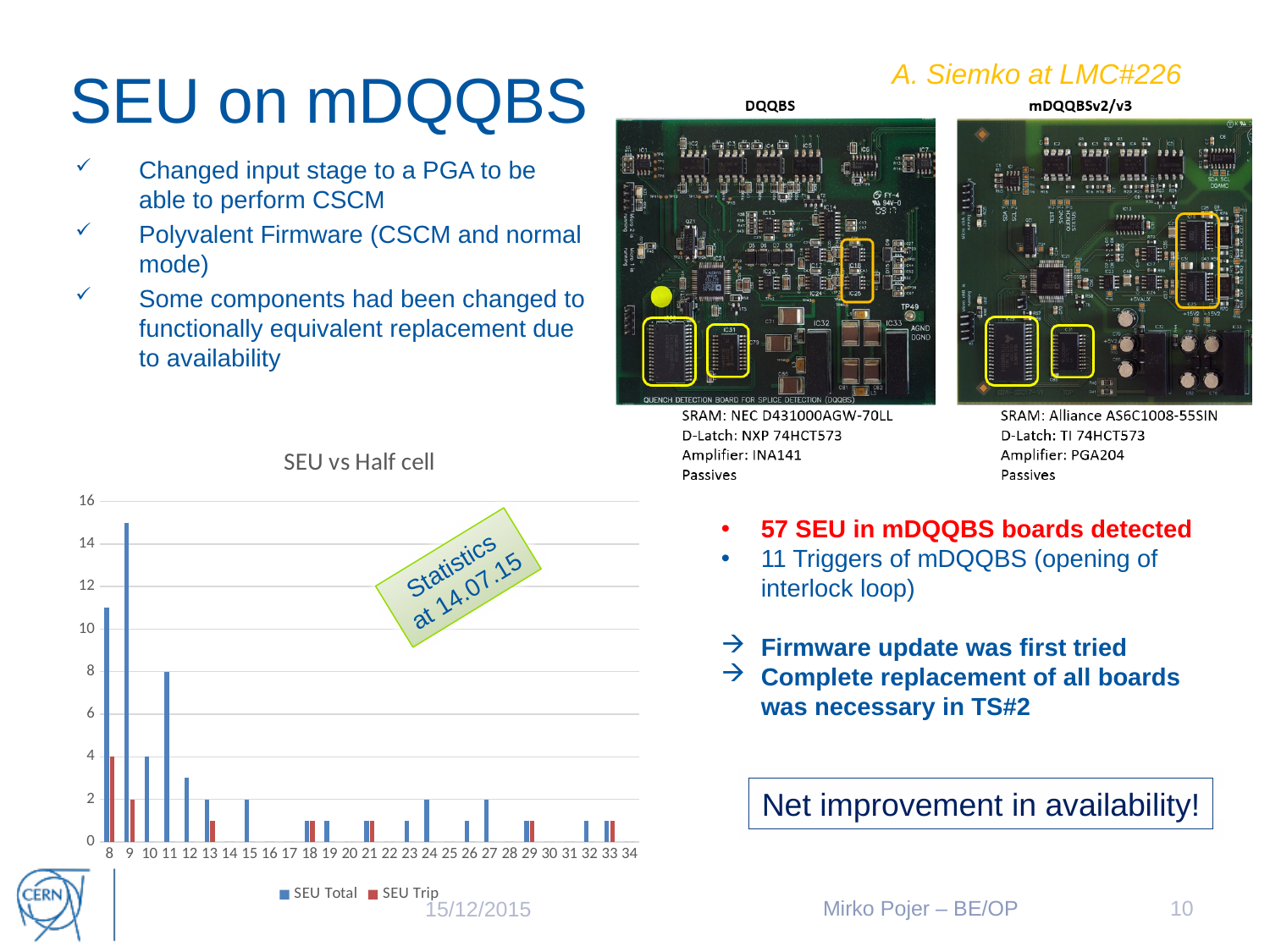
How many series does the chart's legend list? 2 Is the SEU Total for half cell 8 greater or less than 10? greater Which has the larger SEU Total, half cell 8 or half cell 11? half cell 8 What is the title of the chart on the slide? SEU vs Half cell Which half cell has the highest SEU Total? 9 What kind of chart is shown on the slide? bar chart Is the SEU Total for half cell 9 greater or less than 14? greater What is the SEU Total for half cell 11? 8 What are the two series named in the chart's legend? SEU Total and SEU Trip How many half cells are shown along the x axis of the chart? 27 Do the SEU Total values generally rise or fall as the half cell number increases along the x axis? fall Is the SEU Total for half cell 12 greater or less than 4? less